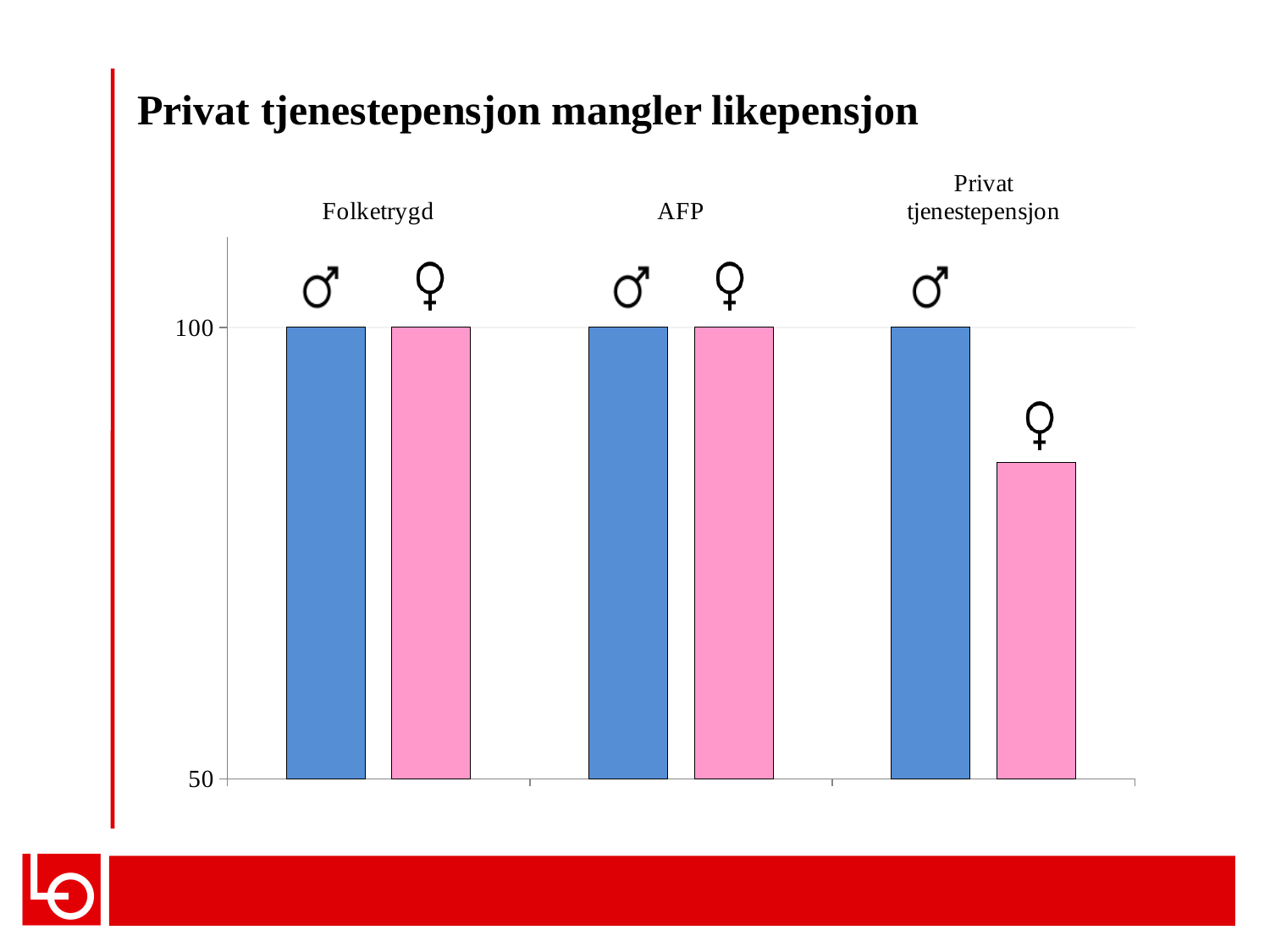
What is the title of the slide? Privat tjenestepensjon mangler likepensjon What is the value of the male (♂) bar for Folketrygd? 100 What is the value of the female (♀) bar for AFP? 100 What is the value of the male (♂) bar for Privat tjenestepensjon? 100 How many pension categories are shown along the x axis? 3 What colour are the female (♀) bars in the chart? pink What kind of chart is shown on the slide? bar chart For Privat tjenestepensjon, which is larger, the male (♂) bar or the female (♀) bar? male (♂) Which bar is the lowest in the chart? female (♀) bar for Privat tjenestepensjon Is the value of the female (♀) bar for Privat tjenestepensjon greater or less than 50? greater Is the value of the female (♀) bar for Privat tjenestepensjon greater or less than 100? less What is the difference between the male (♂) and female (♀) bars for Folketrygd? 0